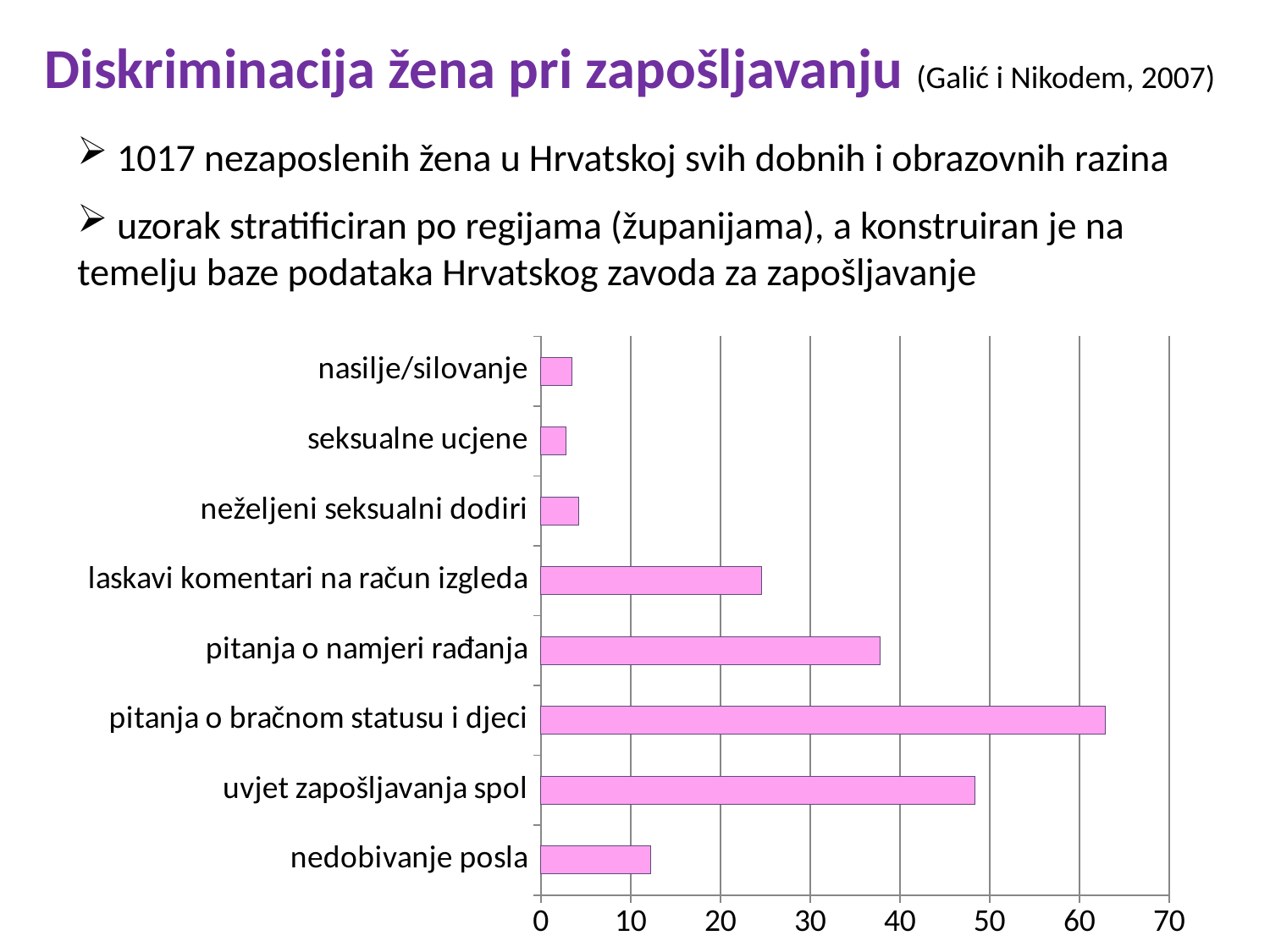
Is the value for "uvjet zapošljavanja spol" greater or less than 40? greater Is the value for "pitanja o namjeri rađanja" greater or less than 40? less What kind of chart is shown on the slide? bar chart How many categories are shown in the bar chart? 8 Is the value for "pitanja o bračnom statusu i djeci" greater or less than 60? greater What is the maximum value shown on the horizontal axis of the chart? 70 Which is larger: the value for "nedobivanje posla" or for "laskavi komentari na račun izgleda"? laskavi komentari na račun izgleda Which is larger: the value for "uvjet zapošljavanja spol" or for "pitanja o namjeri rađanja"? uvjet zapošljavanja spol Which category has the highest value in the chart? pitanja o bračnom statusu i djeci